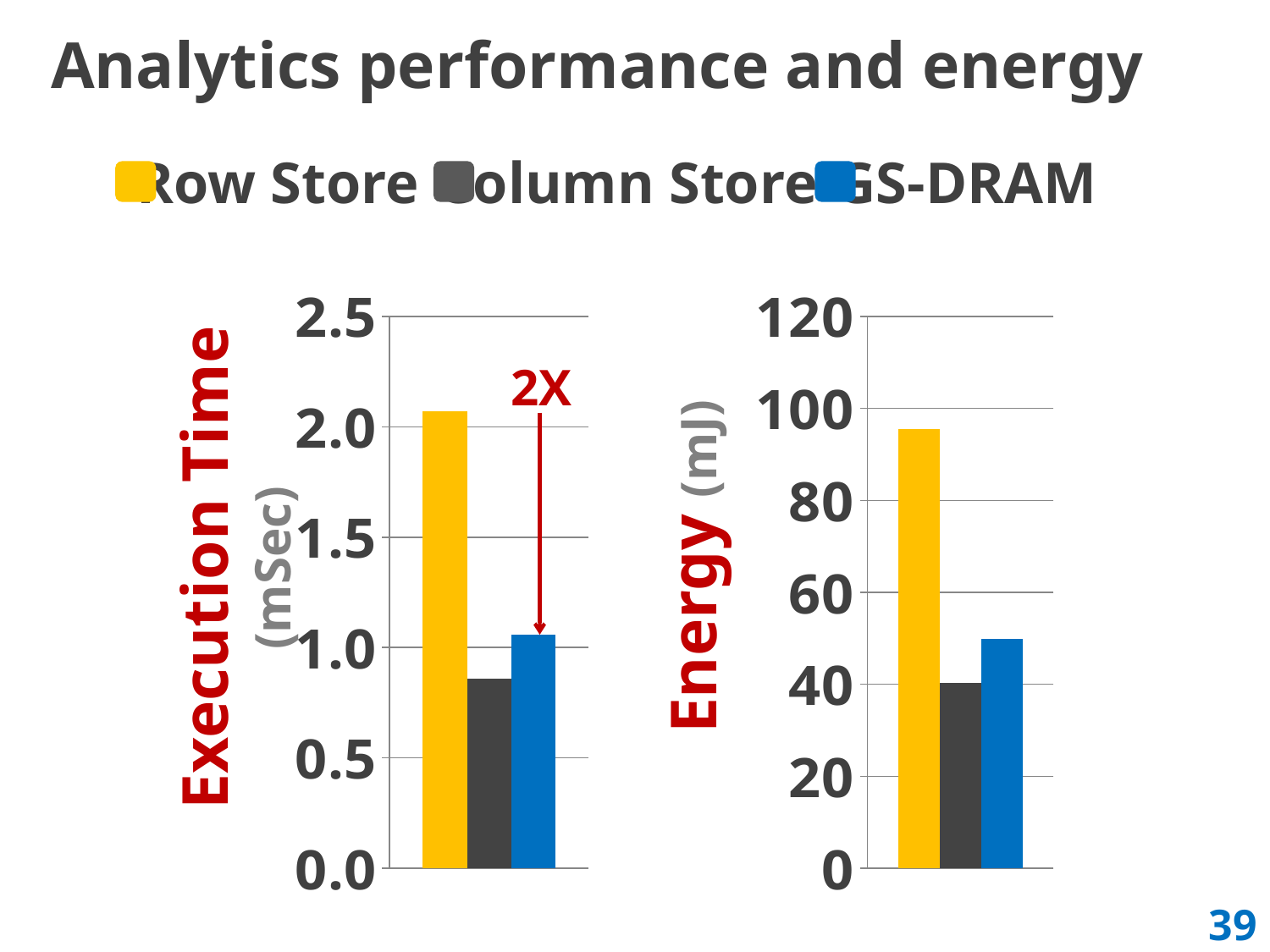
In the Execution Time chart, which series has the highest value? Row Store In the Execution Time chart, which series has the lowest value? Column Store How many series does the legend list? 3 In the Energy chart, which series has the highest value? Row Store In the Energy chart, is the value for GS-DRAM greater or less than 60? less In the Energy chart, which is larger, the value for GS-DRAM or the value for Column Store? GS-DRAM What kind of chart is the Execution Time chart on the left? bar chart In the Execution Time chart, is the value for Column Store greater or less than 1.0? less In the Energy chart, is the value for Row Store greater or less than 100? less What unit is shown on the y axis of the Energy chart? mJ In the Energy chart, which series has the lowest value? Column Store